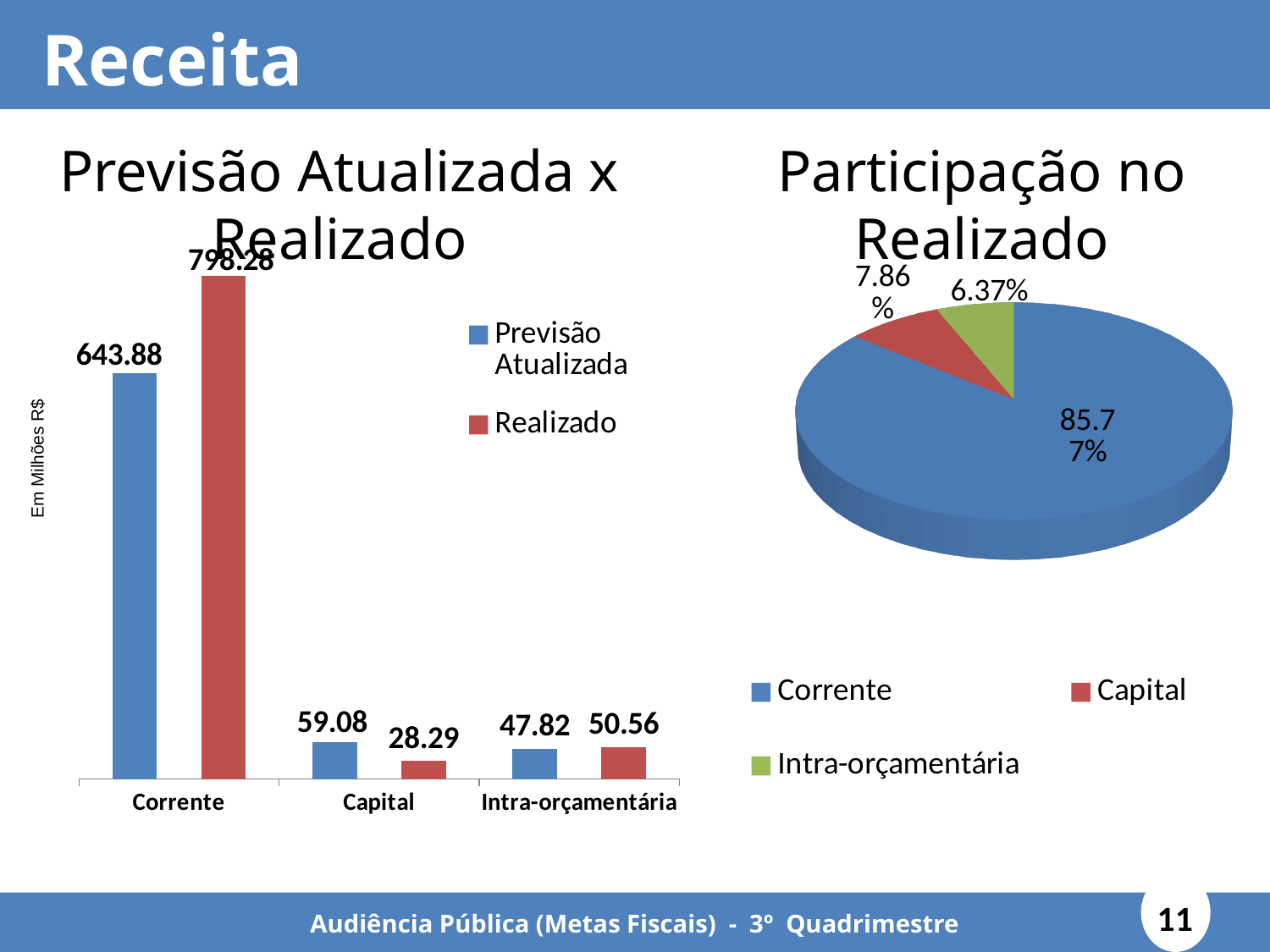
In the 'Previsão Atualizada x Realizado' chart, what is the difference between Previsão Atualizada and Realizado for Capital? 30.79 How many series does the legend of the 'Previsão Atualizada x Realizado' chart list? 2 In the 'Previsão Atualizada x Realizado' chart, what is the Realizado value for Capital? 28.29 In the 'Participação no Realizado' pie chart, which category has the largest slice? Corrente In the 'Previsão Atualizada x Realizado' chart, what is the Realizado value for Intra-orçamentária? 50.56 In the 'Previsão Atualizada x Realizado' chart, which category has the lowest Realizado value? Capital What kind of chart is 'Previsão Atualizada x Realizado'? bar chart How many slices does the 'Participação no Realizado' pie chart have? 3 In the 'Previsão Atualizada x Realizado' chart, what is the Previsão Atualizada value for Capital? 59.08 In the 'Previsão Atualizada x Realizado' chart, what is the Previsão Atualizada value for Corrente? 643.88 In the 'Participação no Realizado' pie chart, what share does Capital have? 7.86% In the 'Previsão Atualizada x Realizado' chart, is the Previsão Atualizada value for Intra-orçamentária larger or smaller than its Realizado value? smaller